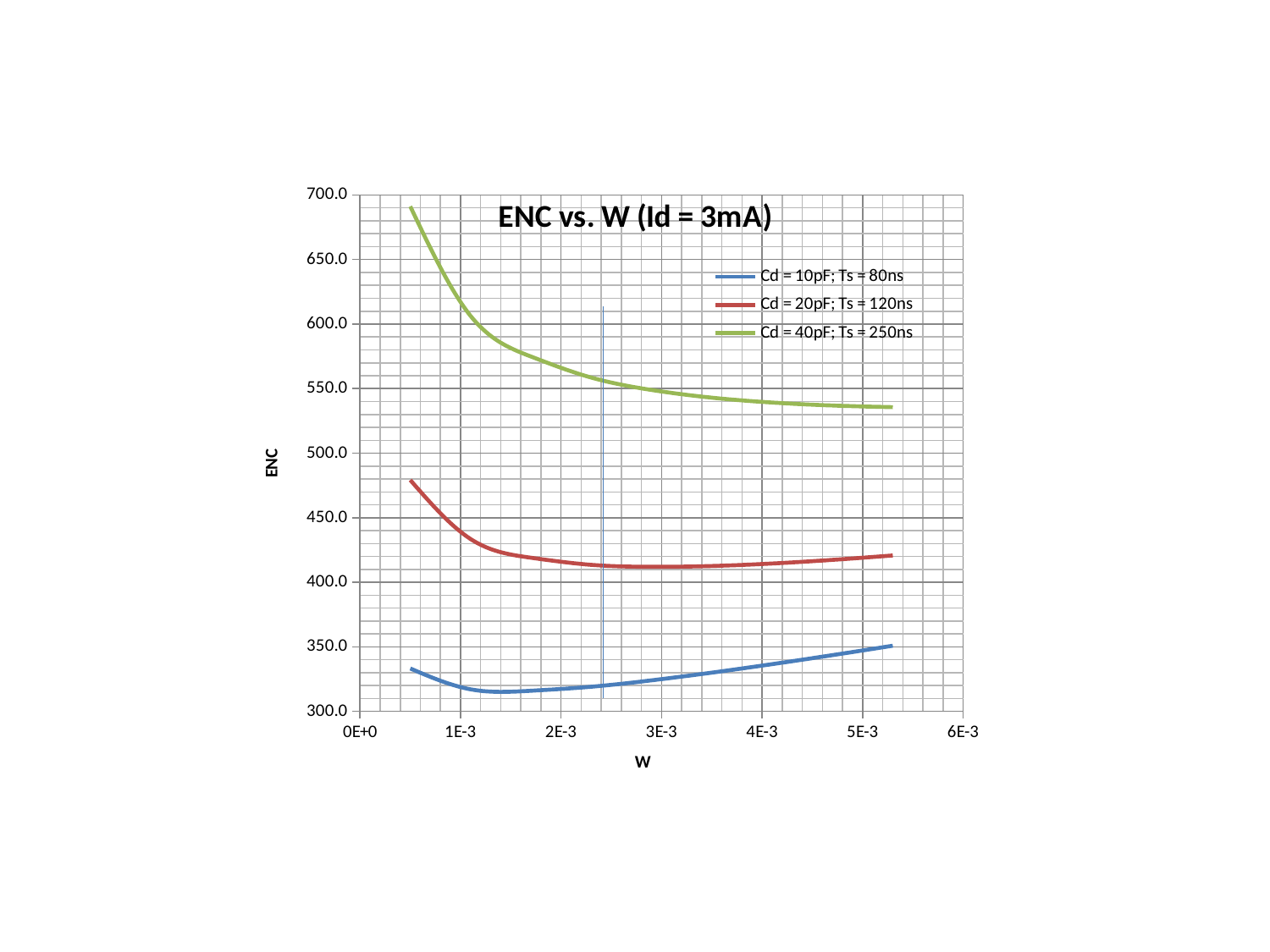
Does the ENC value for the Cd = 10pF; Ts = 80ns series rise or fall as W increases from 3E-3 to 5E-3? rise At W = 1E-3, which series has the larger ENC value: Cd = 20pF; Ts = 120ns or Cd = 10pF; Ts = 80ns? Cd = 20pF; Ts = 120ns Which series has the lowest ENC values across the plotted range of W? Cd = 10pF; Ts = 80ns Is the ENC value for the Cd = 40pF; Ts = 250ns series at W = 5E-3 greater or less than 500.0? greater Is the ENC value for the Cd = 20pF; Ts = 120ns series at W = 3E-3 greater or less than 450.0? less What kind of chart is shown on the slide? line chart Which series has the highest ENC values across the plotted range of W? Cd = 40pF; Ts = 250ns Does the ENC value for the Cd = 40pF; Ts = 250ns series rise or fall as W increases from 1E-3 to 5E-3? fall What is the title of the chart? ENC vs. W (Id = 3mA) Is the ENC value for the Cd = 10pF; Ts = 80ns series at W = 2E-3 greater or less than 350.0? less Which series is plotted in green? Cd = 40pF; Ts = 250ns How many series does the legend list? 3